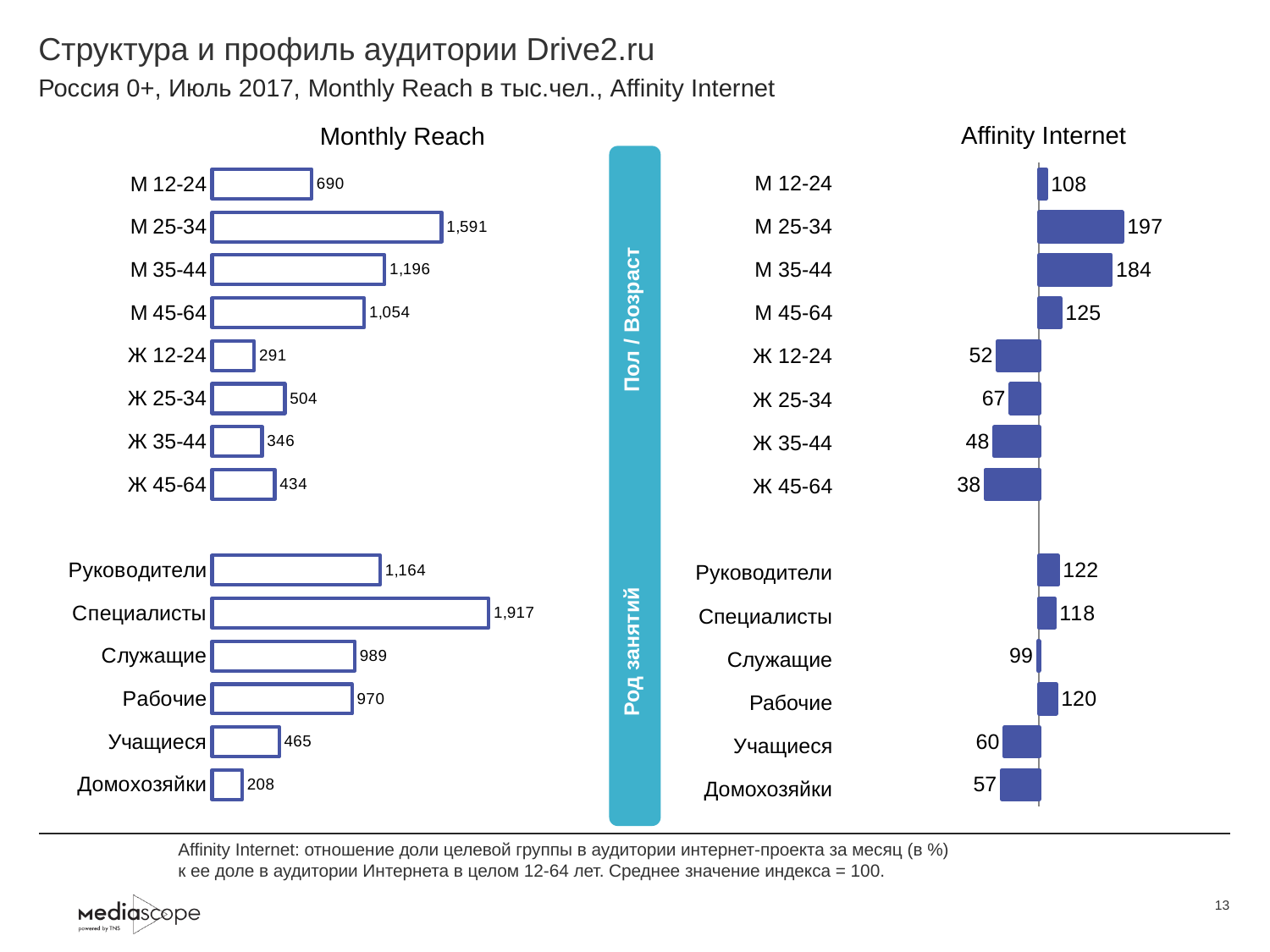
In the Affinity Internet chart, what is the difference between the values for М 35-44 and М 45-64? 59 How many categories are shown in the Monthly Reach chart? 14 In the Monthly Reach chart, what is the difference between the values for Руководители and Служащие? 175 In the Affinity Internet chart, which category has the highest value? М 25-34 In the Monthly Reach chart, what is the value for М 25-34? 1,591 In the Monthly Reach chart, which category has the highest value? Специалисты In the Monthly Reach chart, which is larger: the value for Ж 25-34 or Ж 45-64? Ж 25-34 In the Affinity Internet chart, what is the value for Ж 45-64? 38 In the Affinity Internet chart, which is larger: the value for Учащиеся or Домохозяйки? Учащиеся In the Monthly Reach chart, which category has the lowest value? Домохозяйки In the Affinity Internet chart, which category has the lowest value? Ж 45-64 What kind of chart is the Affinity Internet chart? Bar chart